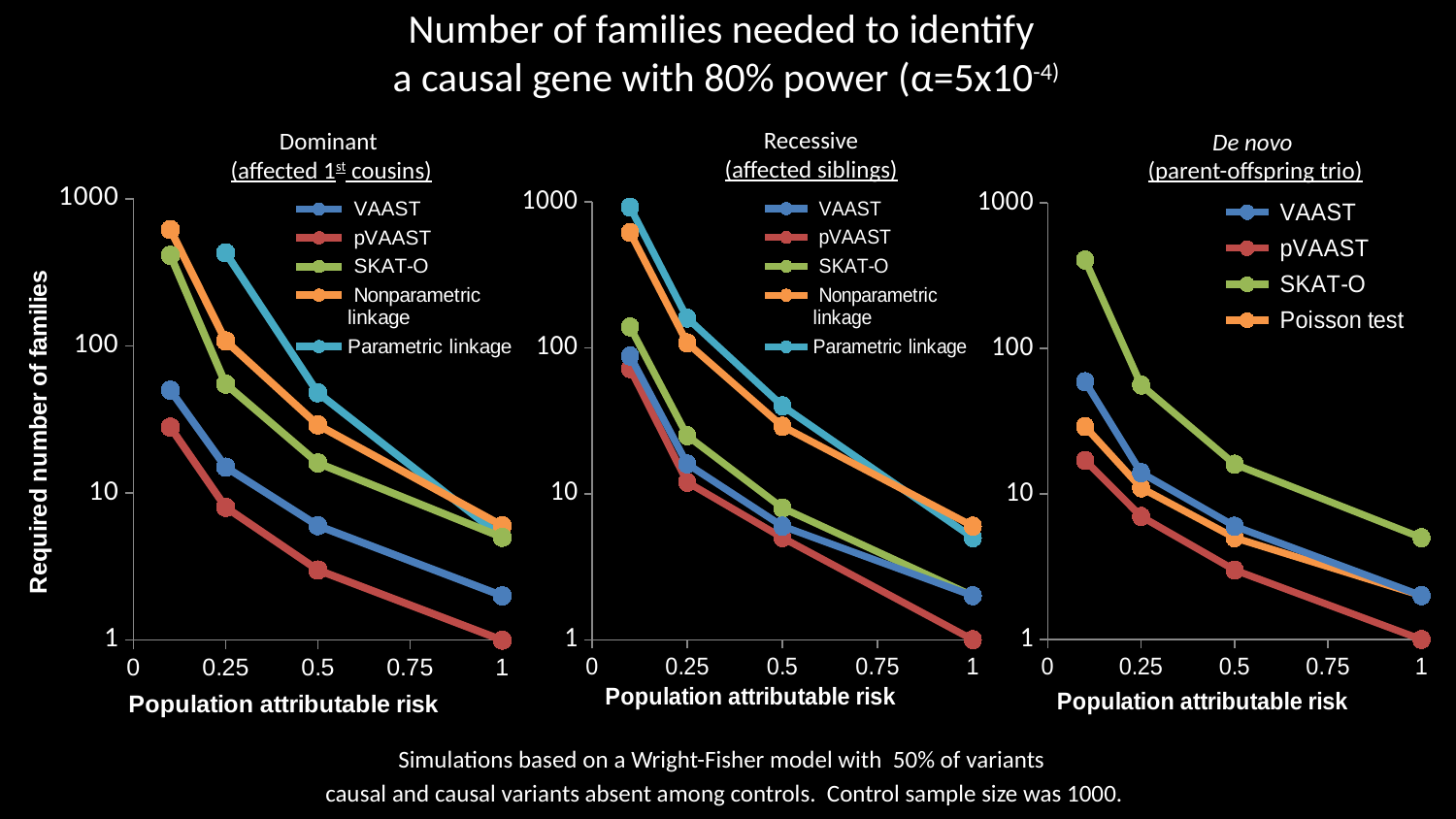
In the De novo (parent-offspring trio) chart, which series has the lowest value at a population attributable risk of 1? pVAAST In the De novo (parent-offspring trio) chart, how many series does the legend list? 4 In the De novo (parent-offspring trio) chart, is the value for pVAAST at a population attributable risk of 0.1 greater or less than 100? less In the Dominant (affected 1st cousins) chart, what is the required number of families for pVAAST at a population attributable risk of 1? 1 What is the label on the y axis of the charts? Required number of families In the Recessive (affected siblings) chart, do the values for VAAST rise or fall as population attributable risk increases? fall In the Recessive (affected siblings) chart, how many series does the legend list? 5 What kind of chart is the Dominant (affected 1st cousins) chart? line chart In the Recessive (affected siblings) chart, which is larger at a population attributable risk of 0.25: Parametric linkage or SKAT-O? Parametric linkage In the Dominant (affected 1st cousins) chart, is the value for Parametric linkage at a population attributable risk of 0.25 greater or less than 100? greater In the Dominant (affected 1st cousins) chart, which series has the highest value at a population attributable risk of 0.1? Nonparametric linkage In the De novo (parent-offspring trio) chart, which series has the highest value at a population attributable risk of 0.1? SKAT-O